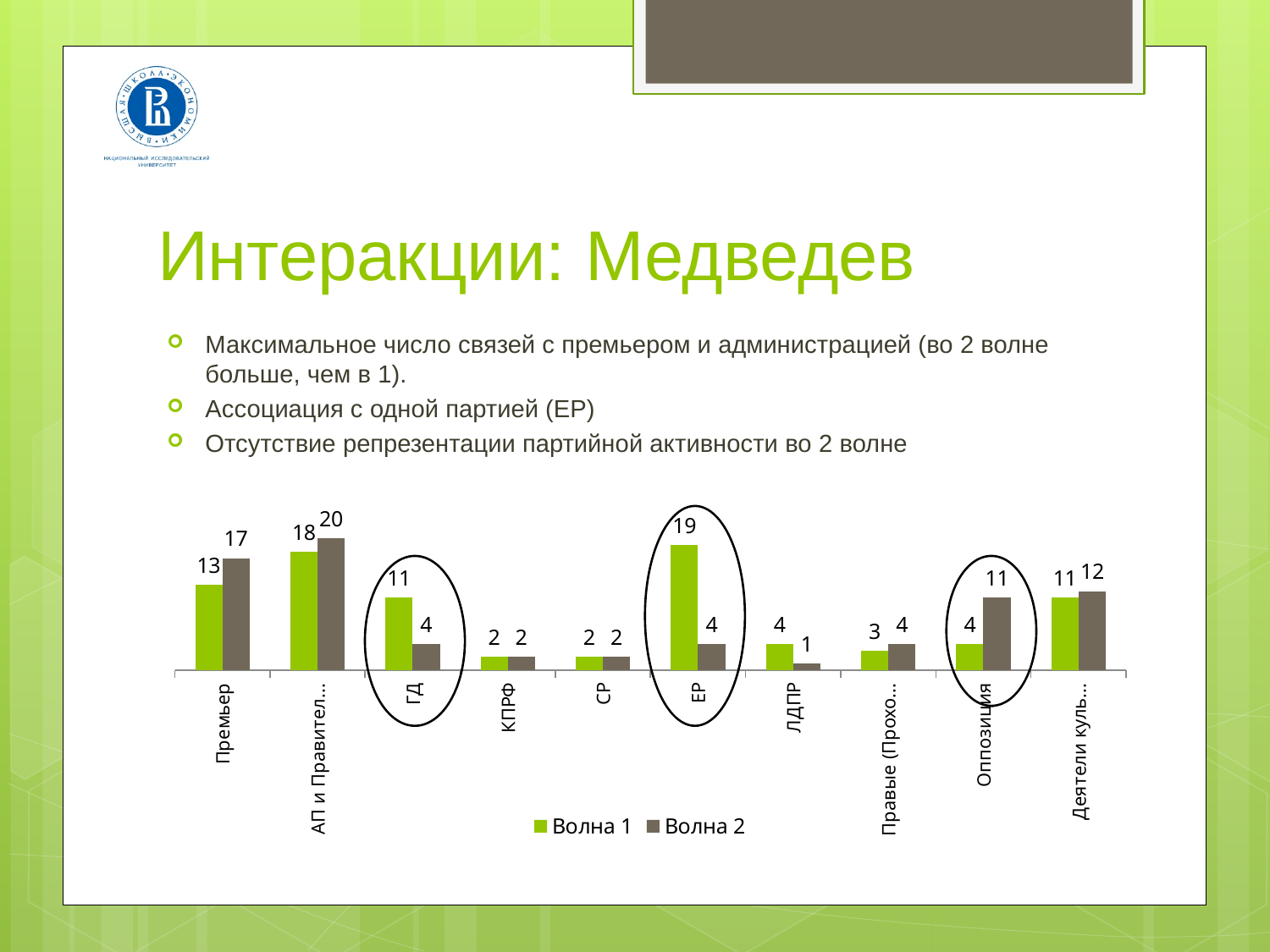
What is the difference between Волна 1 and Волна 2 in the category ЕР? 15 What kind of chart is shown on the slide? bar chart Which category has the highest value for Волна 1? ЕР In the category Оппозиция, which series has the larger value, Волна 1 or Волна 2? Волна 2 What is the value for Волна 2 in the category Оппозиция? 11 What is the difference between Волна 1 and Волна 2 in the category ГД? 7 What is the value for Волна 1 in the category ЕР? 19 How many categories are shown on the x axis of the chart? 10 How many series does the legend list? 2 What are the two legend entries of the chart? Волна 1 and Волна 2 What is the value for Волна 2 in the category Премьер? 17 Which category has the lowest value for Волна 2? ЛДПР